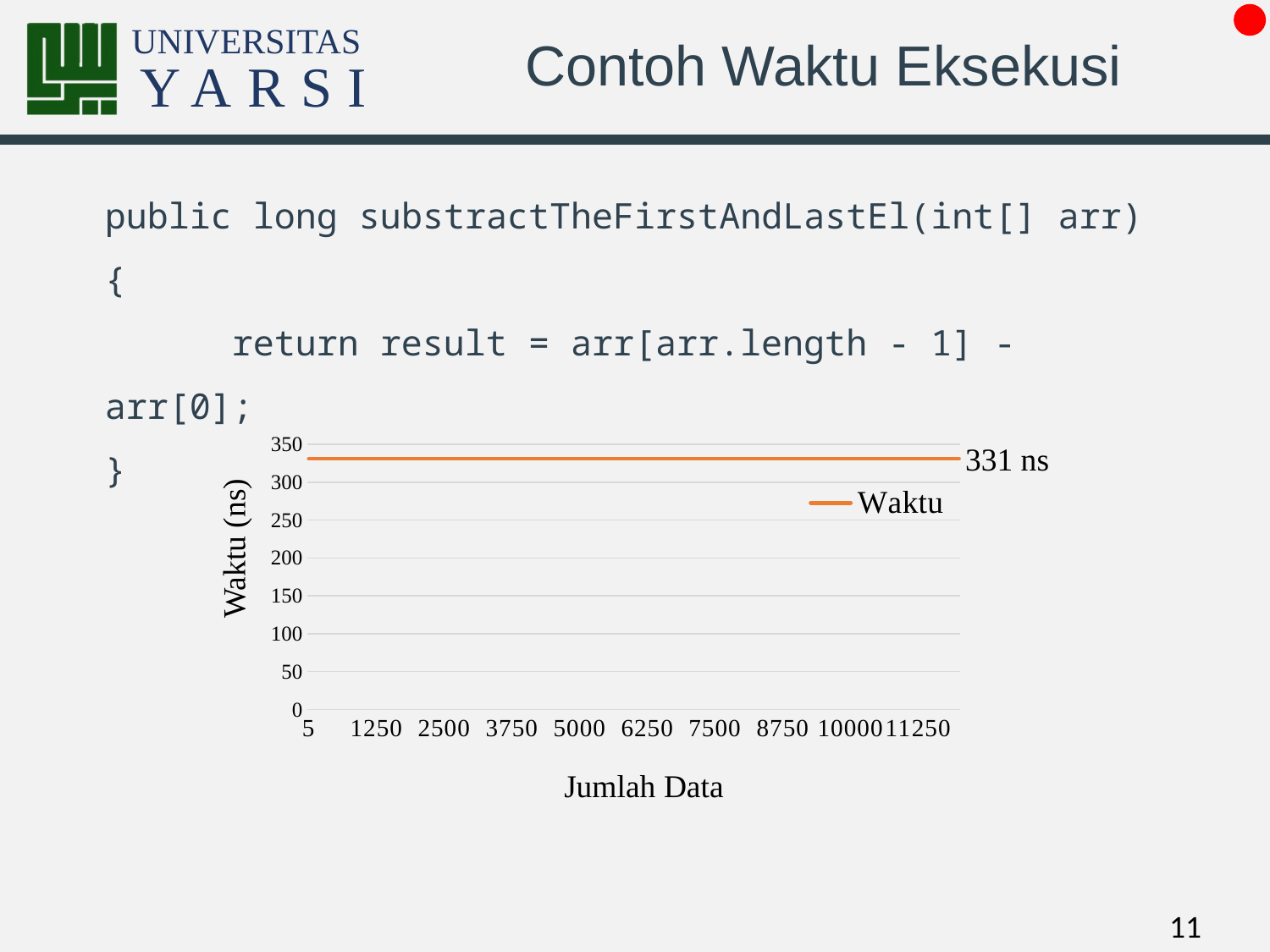
How many series does the chart's legend list? 1 What is the name of the series shown in the chart's legend? Waktu What is the execution time (Waktu) shown for 5000 data items? 331 ns Is the value of the Waktu line greater or less than 350? less What value is printed as the data label on the line in the chart? 331 ns Is the value of the Waktu line greater or less than 300? greater Is the Waktu value at 11250 data items larger than, smaller than, or the same as the value at 5 data items? the same What is the title of the chart's y axis? Waktu (ns) What kind of chart is shown on the slide? line chart Does the plotted line rise, fall, or stay flat as Jumlah Data increases along the x axis? stays flat